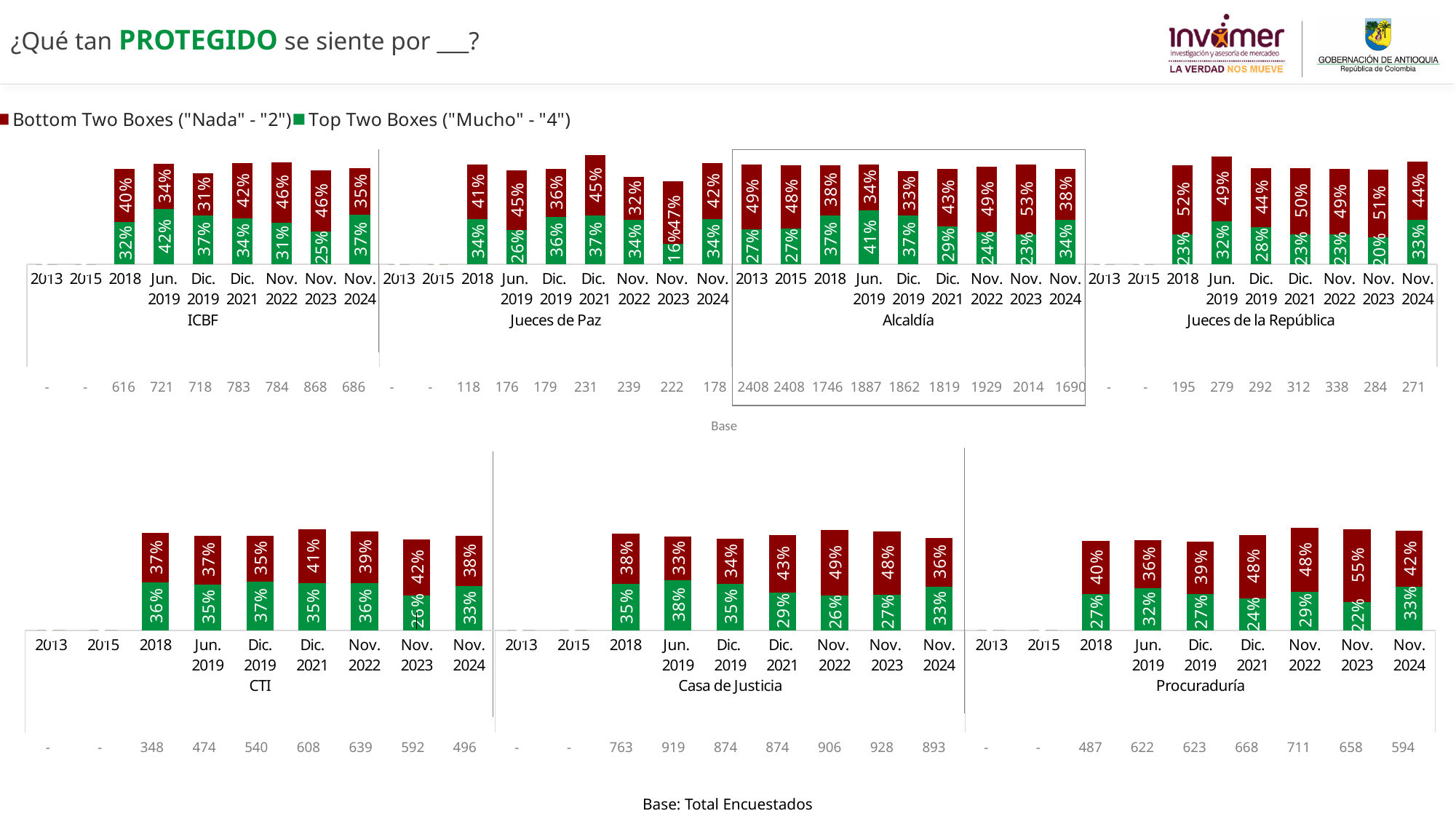
In the bottom chart, what is the Bottom Two Boxes value for Procuraduría in Nov. 2023? 55% In the top chart, which period has the highest Bottom Two Boxes value for Alcaldía? Nov. 2023 In the top chart, what is the total of the stacked bar for ICBF in Nov. 2024? 72% What kind of chart is used on the slide? Stacked bar chart In the top chart, what is the base (number of respondents) for Alcaldía in Nov. 2024? 1690 In the top chart, which period has the lowest Bottom Two Boxes value for Jueces de Paz? Nov. 2022 In the top chart, which is larger for Jueces de la República in Nov. 2024: the Bottom Two Boxes value or the Top Two Boxes value? Bottom Two Boxes In the bottom chart, what is the difference between the Bottom Two Boxes and Top Two Boxes values for CTI in Nov. 2023? 16% How many series does the legend list? 2 In the bottom chart, what is the Top Two Boxes value for Casa de Justicia in Jun. 2019? 38% In the top chart, what is the Top Two Boxes value for Alcaldía in Nov. 2024? 34% In the top chart, what is the Bottom Two Boxes value for Jueces de la República in 2018? 52%